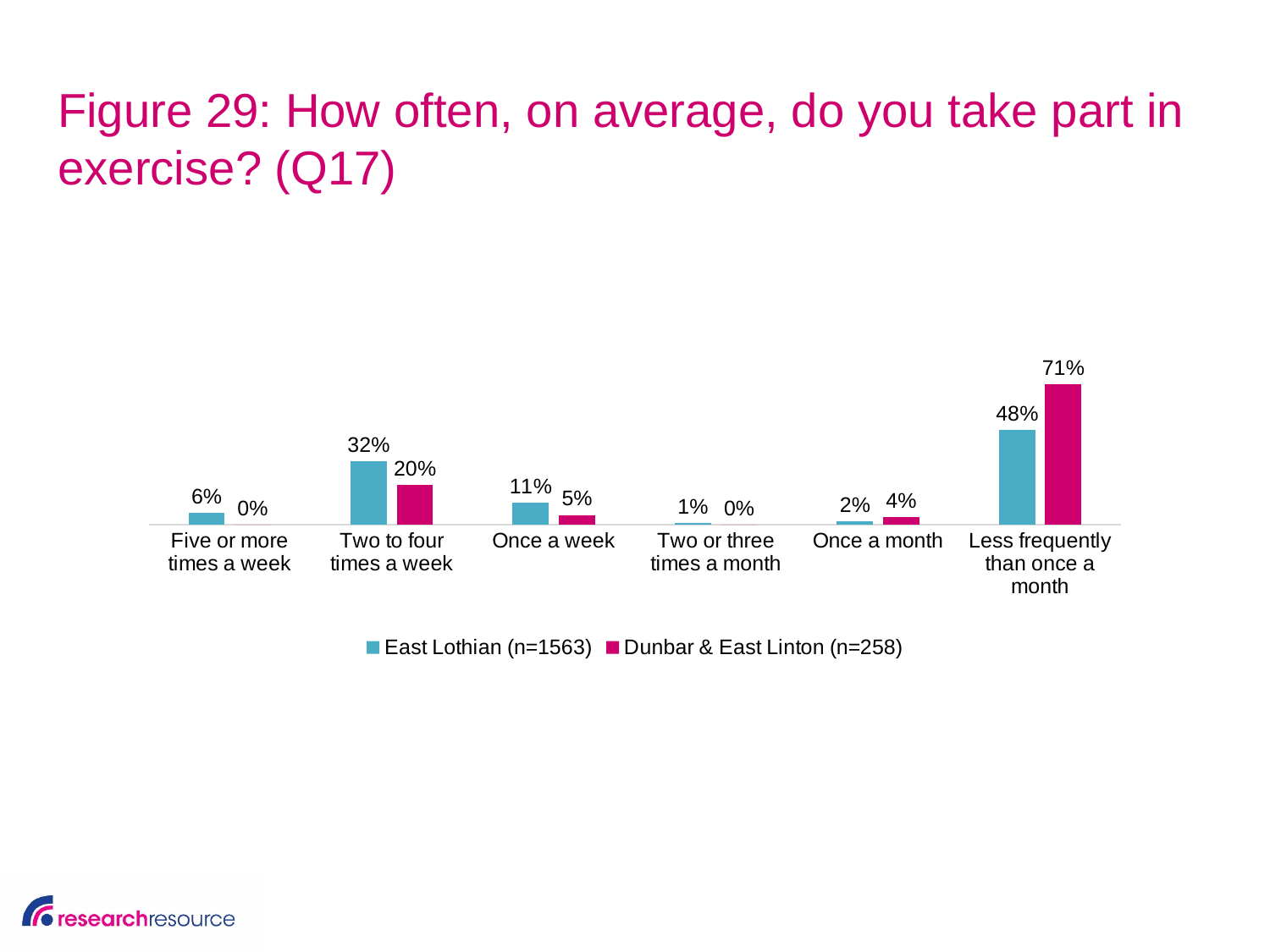
What is the East Lothian value for 'Two to four times a week'? 32% Which category has the highest East Lothian value? Less frequently than once a month What is the Dunbar & East Linton value for 'Less frequently than once a month'? 71% Which category has the lowest East Lothian value? Two or three times a month What is the Dunbar & East Linton value for 'Once a week'? 5% What kind of chart is shown on the slide? Bar chart What is the difference between the East Lothian and Dunbar & East Linton values for 'Two to four times a week'? 12% How many series does the legend list? 2 What is the difference between the Dunbar & East Linton and East Lothian values for 'Less frequently than once a month'? 23% How many categories are shown on the x axis? 6 For 'Once a month', which series has the larger value, East Lothian or Dunbar & East Linton? Dunbar & East Linton What is the East Lothian value for 'Once a month'? 2%